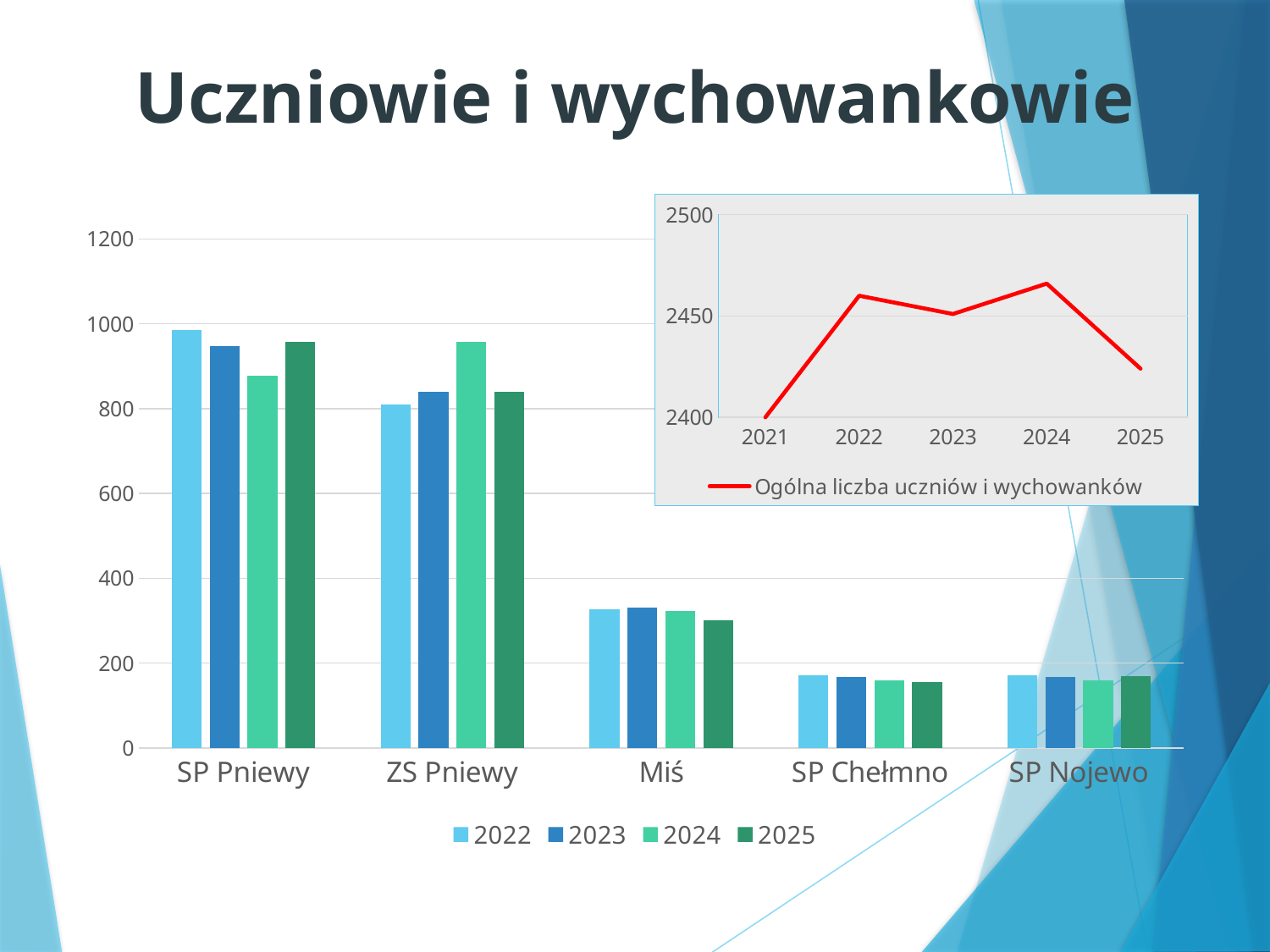
What kind of chart is the inset chart in the top right of the slide? line chart What kind of chart is the large chart on the left of the slide? bar chart In the bar chart, which is larger for 2022: SP Pniewy or ZS Pniewy? SP Pniewy In the bar chart, which category has the highest value for 2024? ZS Pniewy What is the legend entry of the inset line chart? Ogólna liczba uczniów i wychowanków In the bar chart, is the value for Miś in 2025 greater or less than 400? less In the bar chart, is the value for SP Pniewy in 2022 greater or less than 800? greater In the bar chart, how many series does the legend list? 4 In the inset line chart, is the value for 2025 greater or less than 2450? less In the bar chart, how many categories (schools) are shown on the x axis? 5 In the inset line chart, which year has the lowest value? 2021 In the bar chart, which year has the lowest value for SP Pniewy? 2024